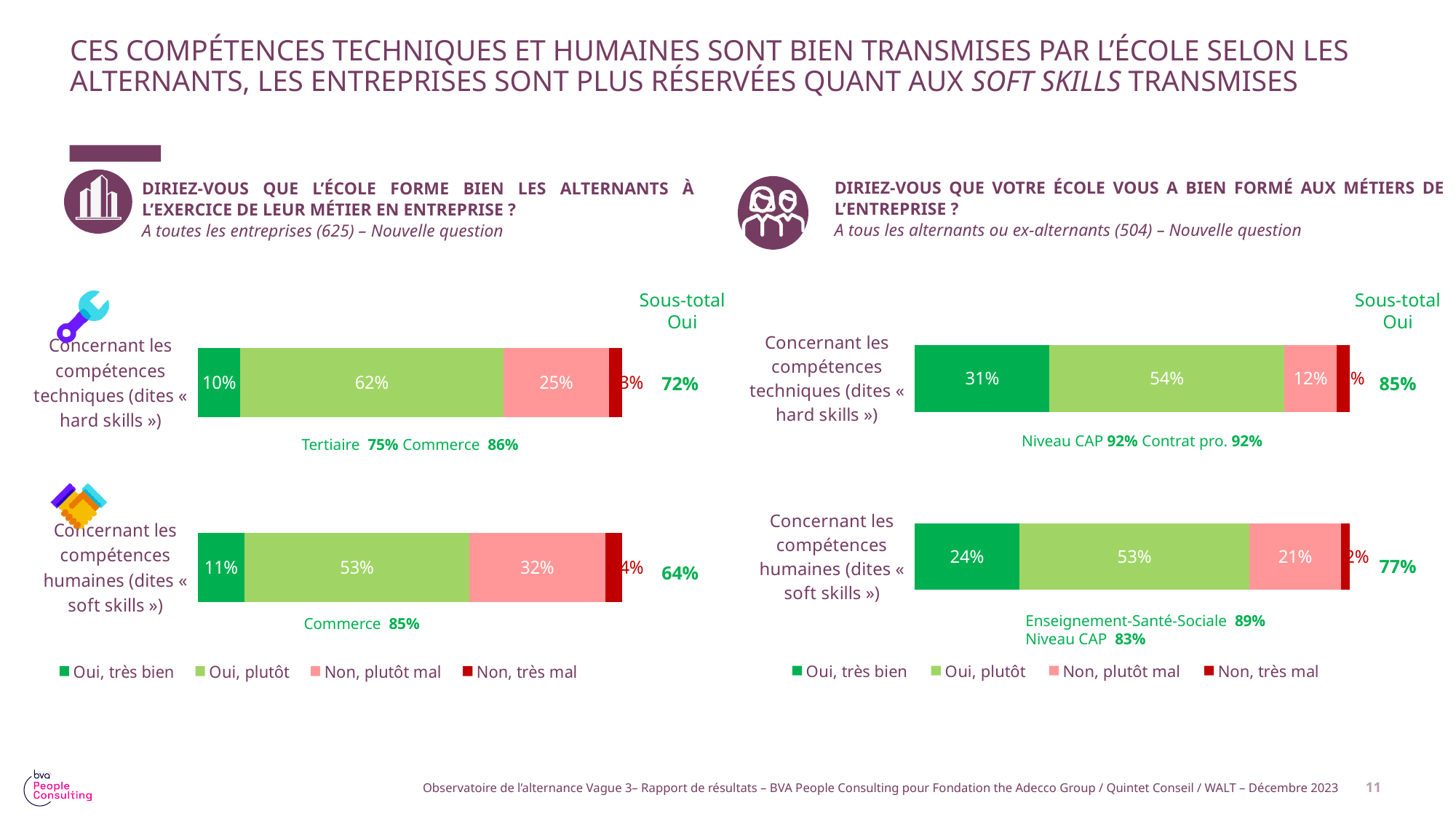
How many series does the legend of the left chart (entreprises) list? 4 In the right chart (alternants), what is the difference in percentage points between the "Sous-total Oui" for hard skills and for soft skills? 8 percentage points In the left chart (entreprises), what is the "Sous-total Oui" for the human skills (soft skills)? 64% In the left chart (entreprises), what percentage answered "Non, plutôt mal" for the human skills (soft skills)? 32% In the right chart (alternants), what percentage answered "Non, plutôt mal" for the human skills (soft skills)? 21% How many categories (bars) are shown in the left chart (entreprises)? 2 In the right chart (alternants), what is the "Sous-total Oui" for the technical skills (hard skills)? 85% In the left chart (entreprises), what percentage answered "Oui, plutôt" for the technical skills (hard skills)? 62% In the right chart (alternants), is the "Oui, très bien" share larger for hard skills or for soft skills? Hard skills In the right chart (alternants), what percentage answered "Oui, très bien" for the technical skills (hard skills)? 31% In the left chart (entreprises), what is the difference in percentage points between the "Oui, plutôt" share for hard skills and for soft skills? 9 percentage points What kind of chart is the right chart (alternants)? Stacked bar chart